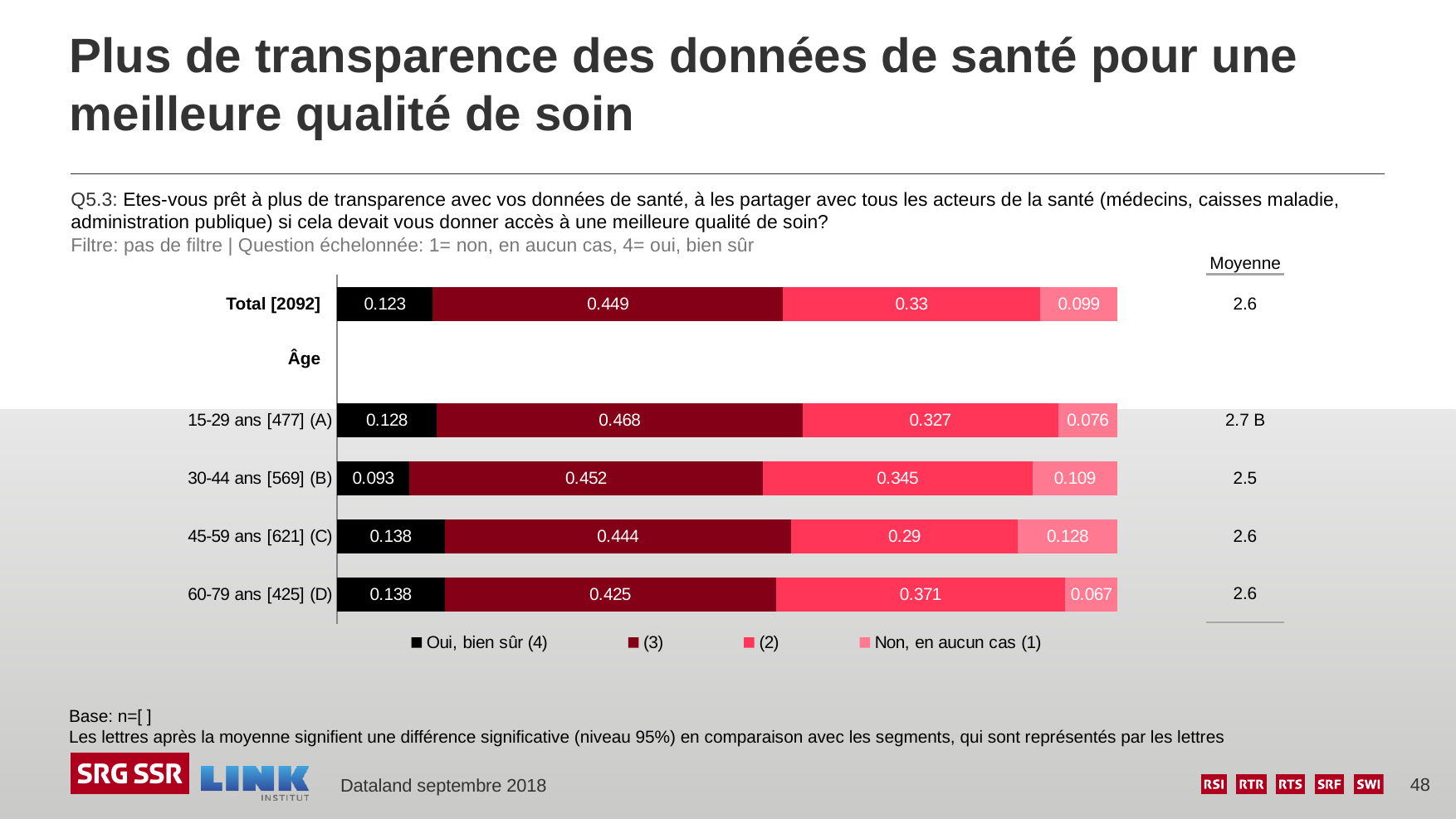
What kind of chart is shown on the slide? Stacked bar chart What is the value of the "Non, en aucun cas (1)" segment for 60-79 ans [425] (D)? 0.067 Which age group has the lowest value for the "Oui, bien sûr (4)" segment? 30-44 ans [569] (B) What is the value of the "Oui, bien sûr (4)" segment for 30-44 ans [569] (B)? 0.093 Which age group has the highest value for the "Non, en aucun cas (1)" segment? 45-59 ans [621] (C) How many bars are plotted in the chart? 5 What is the Moyenne shown for 15-29 ans [477] (A)? 2.7 B What is the value of the "(3)" segment for the Total [2092] bar? 0.449 How many series does the legend list? 4 What is the total of the stacked bar for 15-29 ans [477] (A)? 0.999 Which is larger: the "(3)" segment for 15-29 ans [477] (A) or for 60-79 ans [425] (D)? 15-29 ans [477] (A) What is the difference between the "(2)" segment values for 60-79 ans [425] (D) and 45-59 ans [621] (C)? 0.081